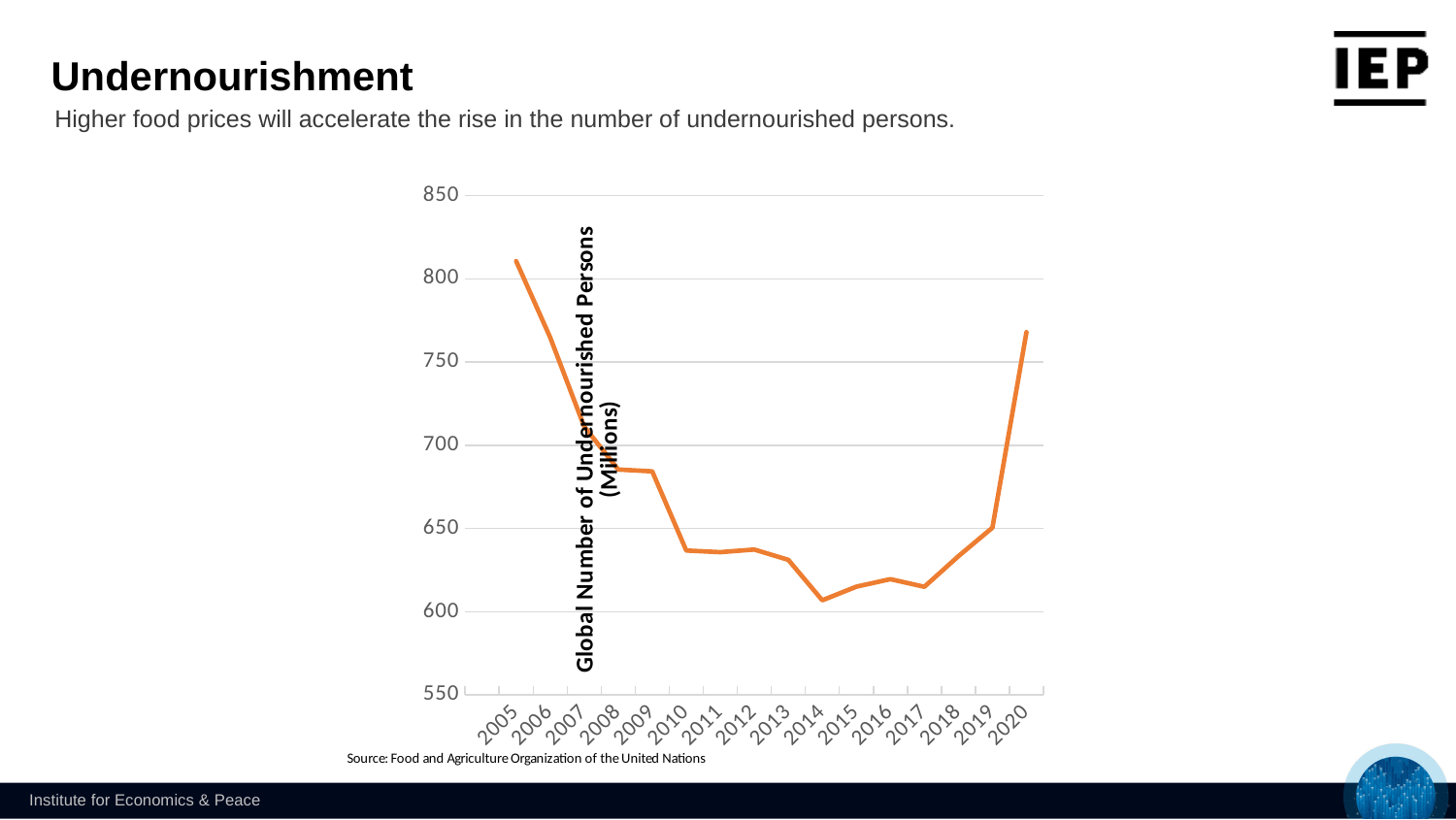
Do the values rise or fall from 2005 to 2014? fall Which year has the highest global number of undernourished persons? 2005 Which year has the lowest global number of undernourished persons? 2014 Is the value for 2008 greater or less than 700? less Which year has a larger value, 2010 or 2019? 2019 How many years are plotted along the x axis of the chart? 16 Which year has a larger value, 2005 or 2020? 2005 Is the value for 2005 greater or less than 800? greater What kind of chart is shown on the slide? line chart Is the value for 2020 greater or less than 750? greater What is the title of the y axis of the chart? Global Number of Undernourished Persons (Millions)